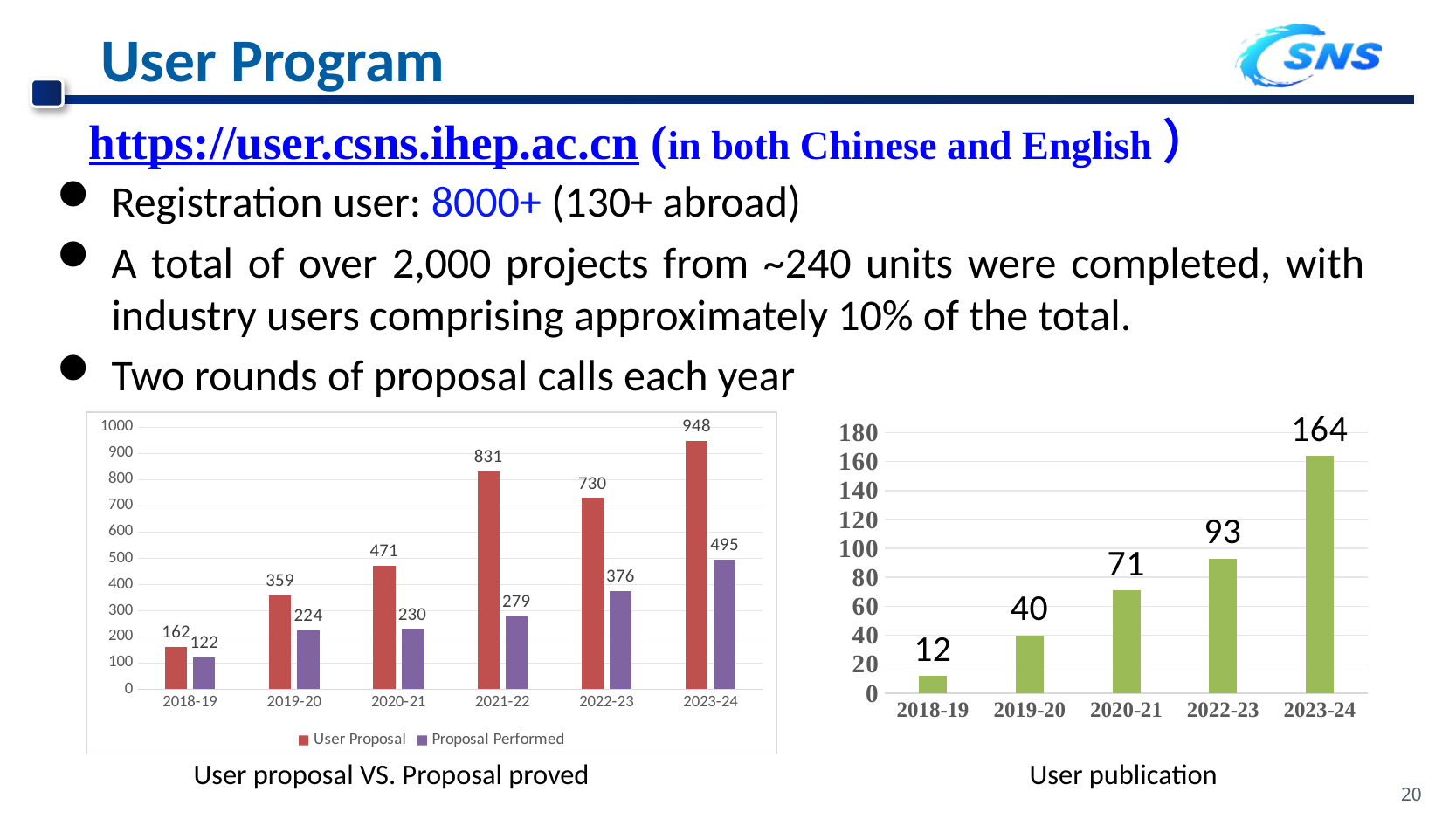
In the right chart (User publication), what is the difference between the 2023-24 and 2022-23 values? 71 In the left chart (User proposal VS. Proposal proved), how many series does the legend list? 2 In the right chart (User publication), which year has the highest value? 2023-24 In the left chart (User proposal VS. Proposal proved), what is the Proposal Performed value for 2021-22? 279 In the right chart (User publication), what is the value for 2020-21? 71 In the right chart (User publication), do the values rise or fall from 2018-19 to 2023-24? rise In the left chart (User proposal VS. Proposal proved), which year has the lowest User Proposal value? 2018-19 In the left chart (User proposal VS. Proposal proved), how many years are shown on the x axis? 6 What kind of chart is the right chart (User publication)? bar chart In the left chart (User proposal VS. Proposal proved), which is larger: the User Proposal value for 2021-22 or for 2022-23? 2021-22 In the left chart (User proposal VS. Proposal proved), what is the difference between User Proposal and Proposal Performed in 2022-23? 354 In the left chart (User proposal VS. Proposal proved), what is the User Proposal value for 2023-24? 948